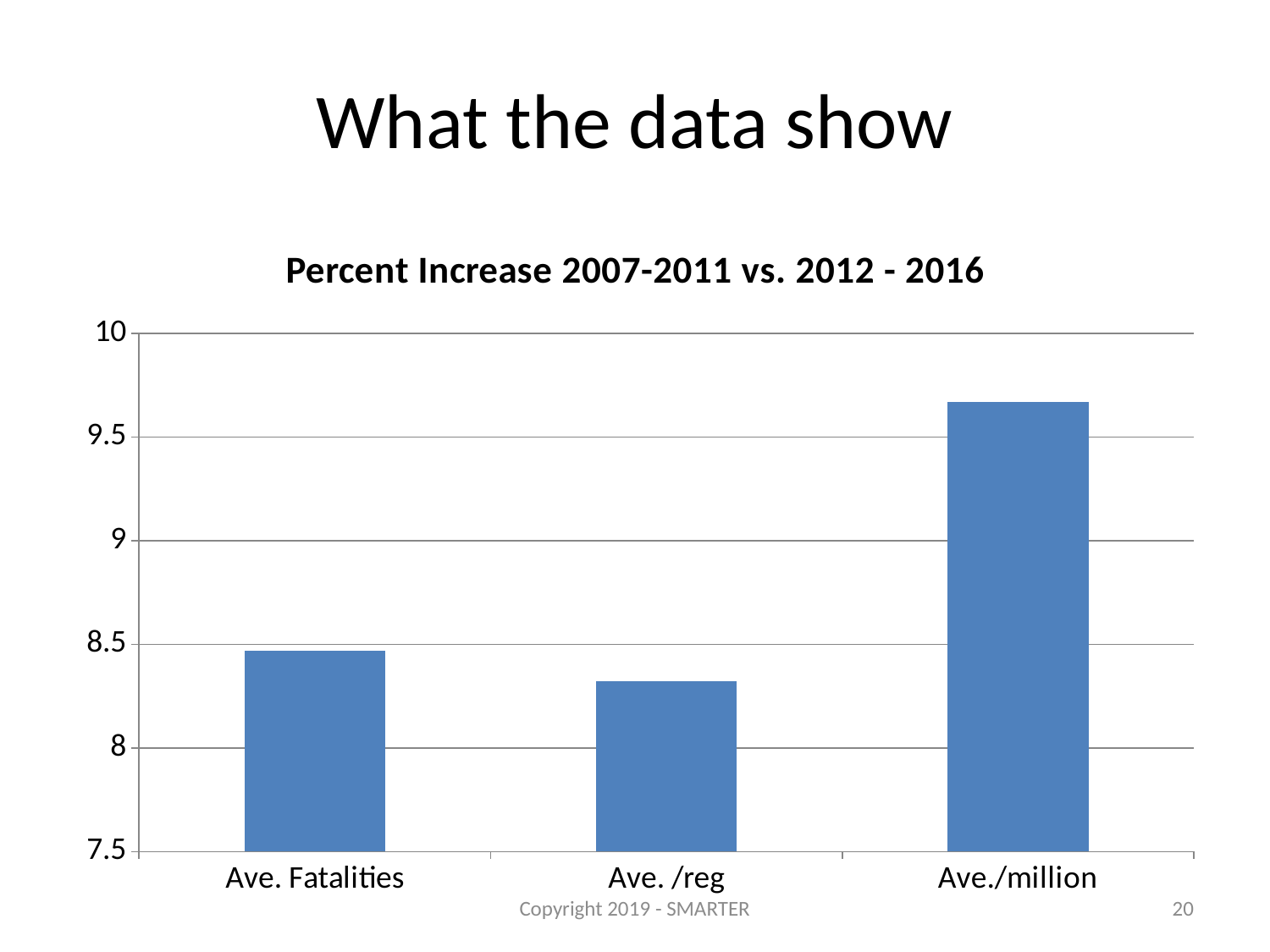
How many categories are plotted in the chart? 3 Is the value for Ave./million greater or less than 9.5? greater Which is larger, the value for Ave. Fatalities or the value for Ave. /reg? Ave. Fatalities What is the lowest value shown on the vertical axis? 7.5 Which category has the highest value? Ave./million Is the value for Ave./million greater or less than 10? less Is the value for Ave. /reg greater or less than 8? greater Which category has the lowest value? Ave. /reg What kind of chart is shown on the slide? bar chart What is the title of the chart? Percent Increase 2007-2011 vs. 2012 - 2016 Does the value rise or fall from Ave. /reg to Ave./million? rise